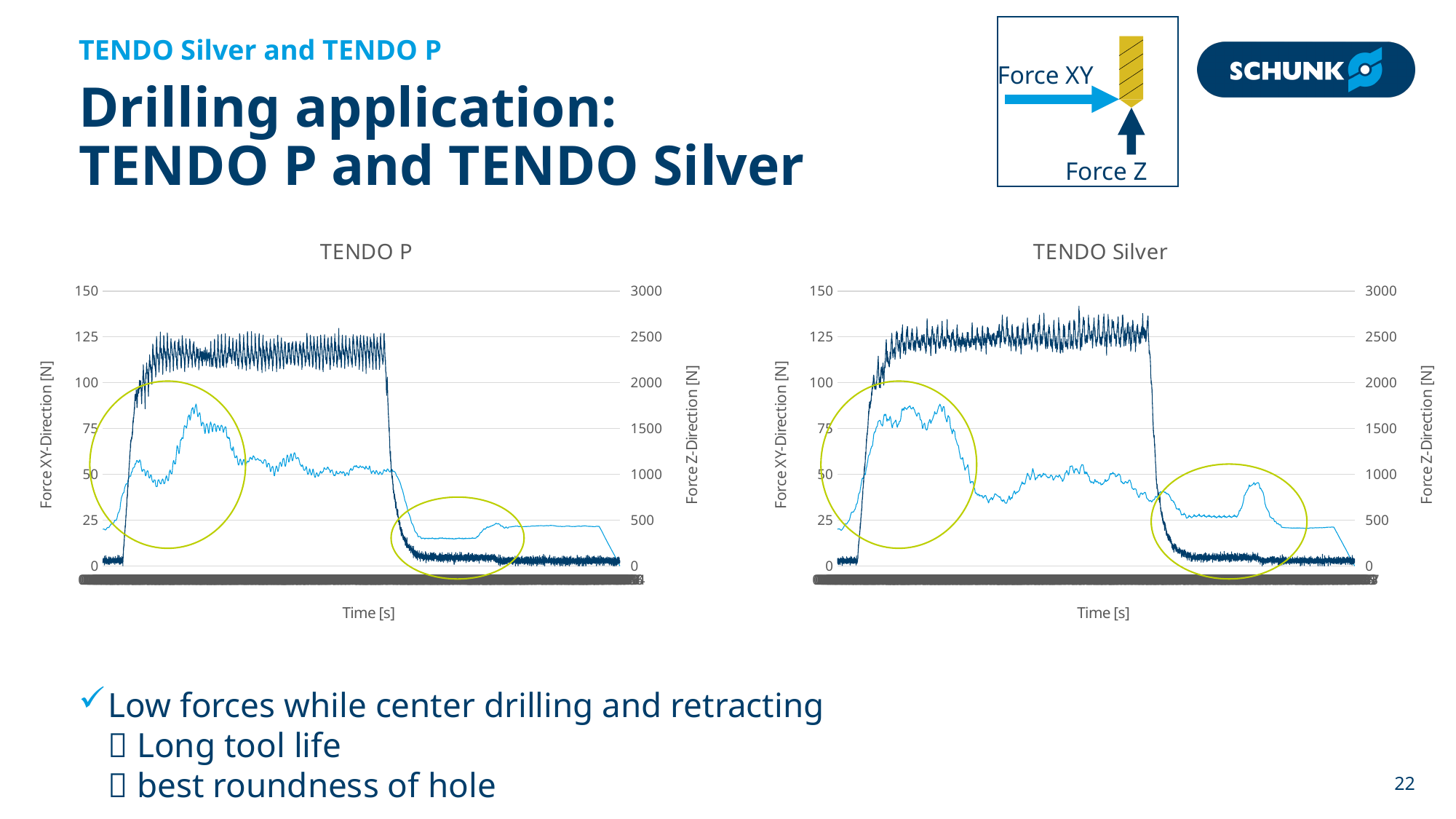
In the TENDO Silver chart, what is the highest tick value shown on the right vertical axis? 3000 In the TENDO P chart, what is the label of the left vertical axis? Force XY-Direction [N] In the TENDO Silver chart, is the plateau of the dark blue line during drilling greater or less than 2000 on the right axis? greater In the TENDO P chart, is the plateau of the dark blue line during drilling greater or less than 100 on the left axis? greater How many charts are shown on the slide? 2 In the TENDO P chart, is the peak of the light blue line greater or less than 100 on the left axis? less How many lines are plotted in the TENDO Silver chart? 2 In the TENDO P chart, does the dark blue line rise or fall at the end of the drilling phase (around the middle of the x axis)? fall What is the title of the chart on the right? TENDO Silver What kind of chart is the TENDO P chart? line chart In the TENDO P chart, what is the highest tick value shown on the left vertical axis? 150